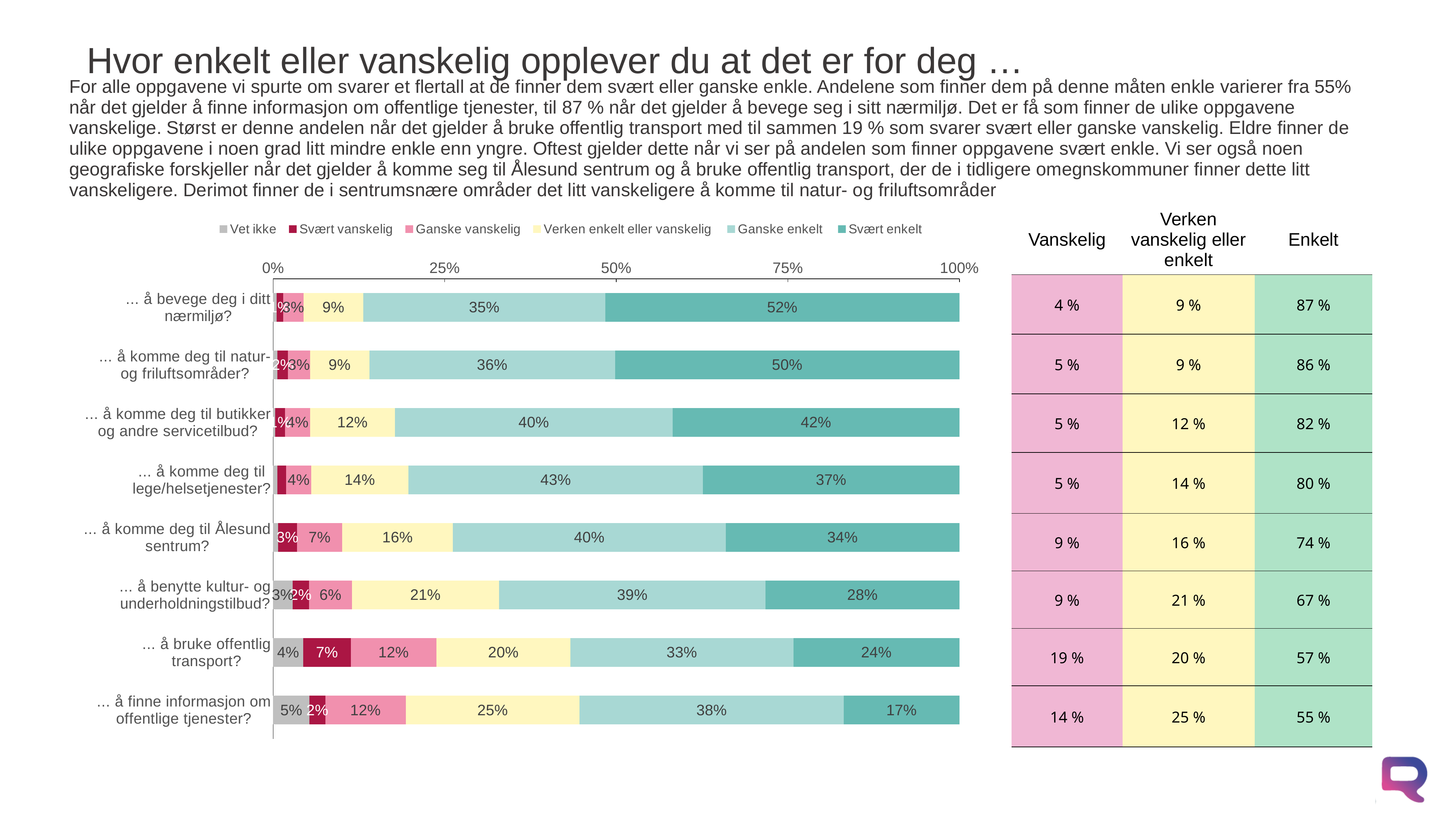
What is the 'Svært vanskelig' value for '… å bruke offentlig transport?'? 7% Which category has the highest 'Svært enkelt' value? … å bevege deg i ditt nærmiljø? Which category has the lowest 'Svært enkelt' value? … å finne informasjon om offentlige tjenester? What is the 'Verken enkelt eller vanskelig' value for '… å finne informasjon om offentlige tjenester?'? 25% What is the 'Ganske enkelt' value for '… å komme deg til lege/helsetjenester?'? 43% What is the difference between the 'Svært enkelt' values for '… å komme deg til natur- og friluftsområder?' and '… å komme deg til Ålesund sentrum?'? 16% How many series does the chart legend list? 6 What kind of chart is shown on the slide? Stacked bar chart What is the 'Svært enkelt' value for '… å bevege deg i ditt nærmiljø?'? 52% Which legend entry is shown in grey? Vet ikke Which is larger: the 'Ganske vanskelig' value for '… å bruke offentlig transport?' or for '… å komme deg til Ålesund sentrum?'? … å bruke offentlig transport? How many categories (questions) are plotted in the chart? 8